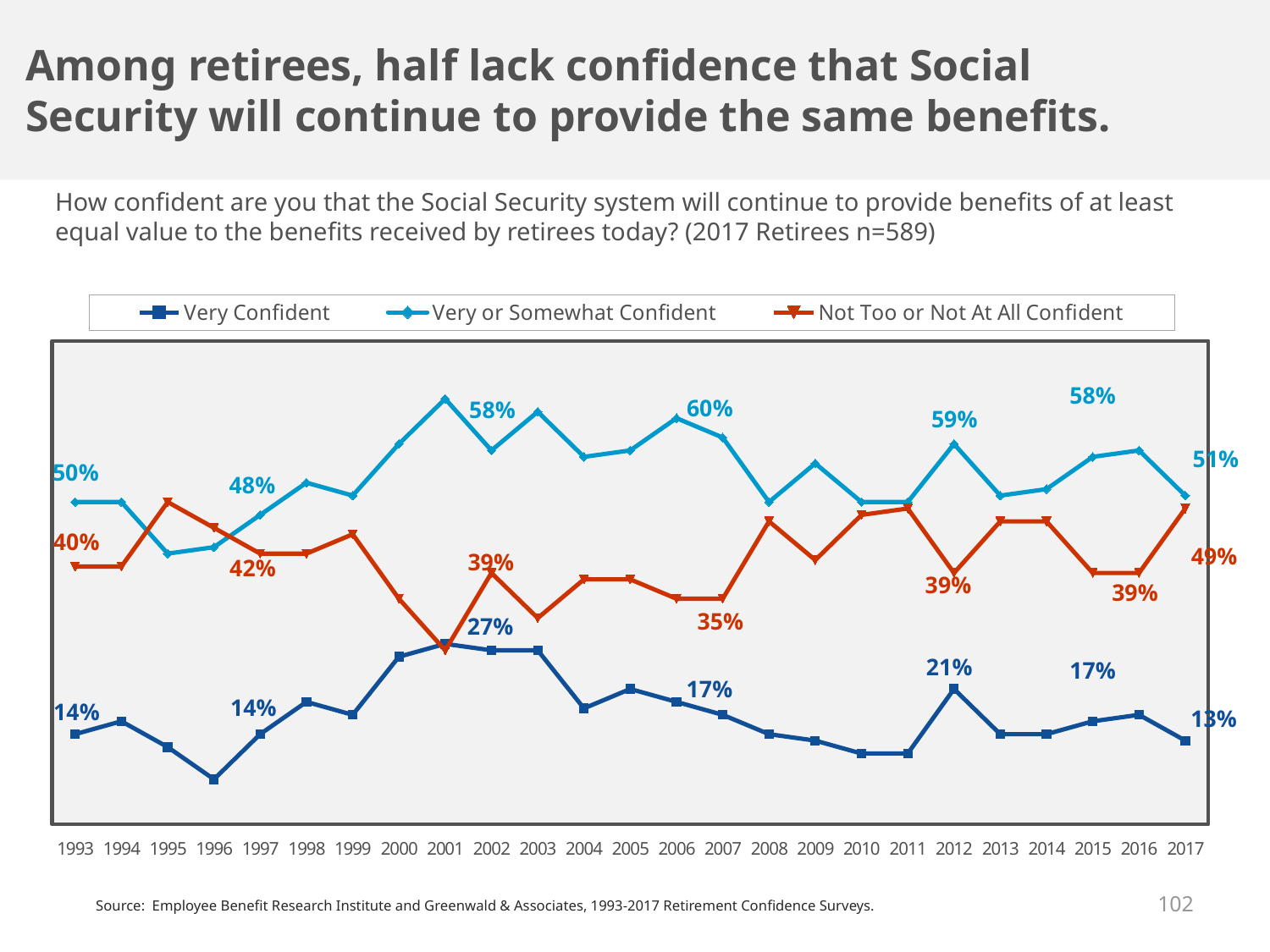
What kind of chart is shown on the slide? Line chart How many series does the legend list? 3 What is the value for Very Confident in 2002? 27% In 2017, what is the difference between Very or Somewhat Confident and Not Too or Not At All Confident? 2 percentage points How many years are shown on the x axis? 25 Which series has the lowest values across the whole chart? Very Confident Between 2016 and 2017, does the Not Too or Not At All Confident line rise or fall? Rise What is the value for Very or Somewhat Confident in 1993? 50% What is the value for Not Too or Not At All Confident in 2007? 35% In 1993, which is larger: Very or Somewhat Confident or Not Too or Not At All Confident? Very or Somewhat Confident What is the value for Very Confident in 2012? 21% What is the value for Not Too or Not At All Confident in 2017? 49%